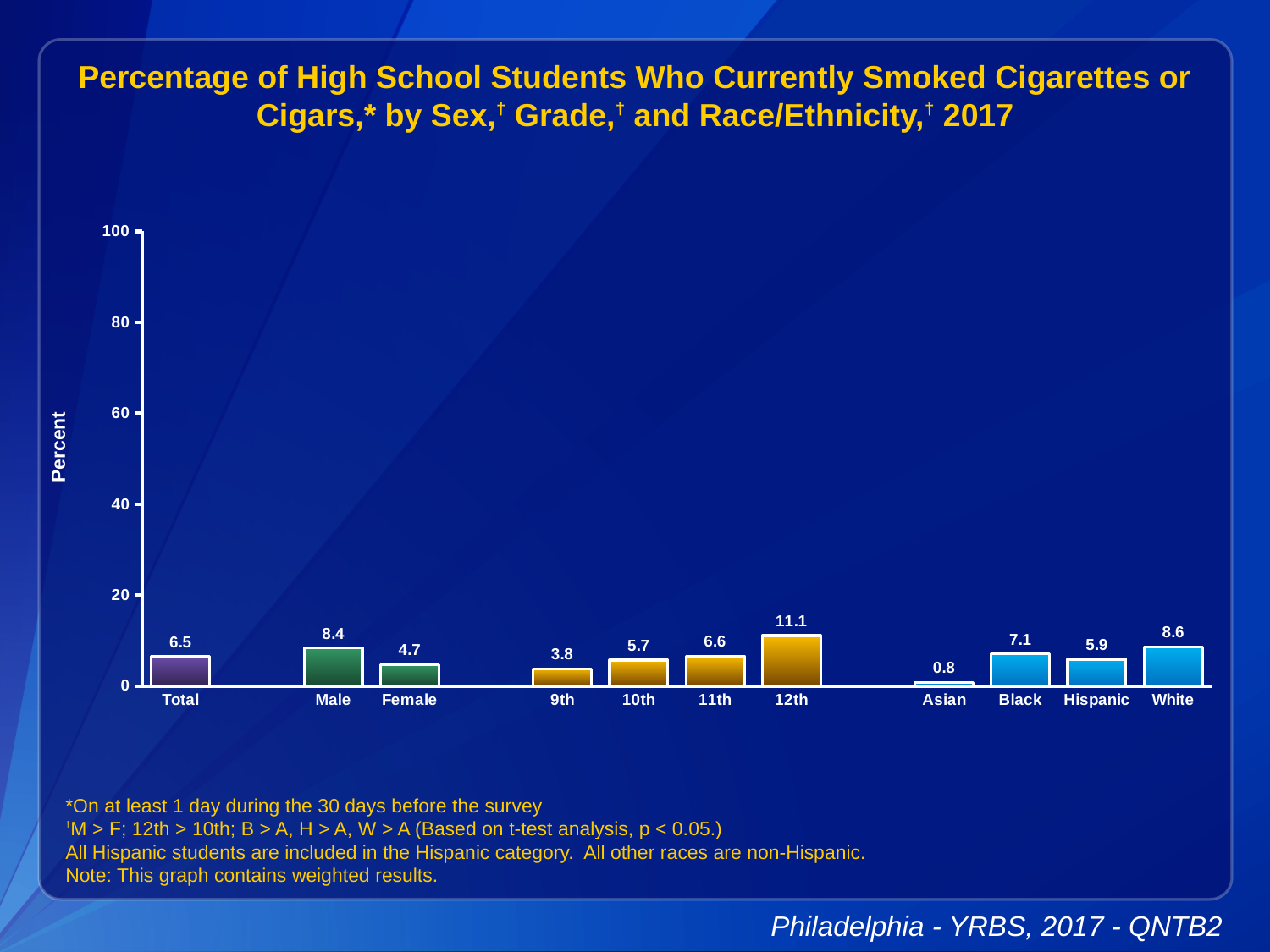
What is the value for 12th grade? 11.1 What is the value for Asian? 0.8 Which is larger, the value for Black or the value for Hispanic? Black Which category has the lowest value? Asian What is the value for Total? 6.5 Do the values rise or fall from 9th grade to 12th grade? rise Which category has the highest value? 12th What kind of chart is this? bar chart Is the value for White greater or less than 20? less What is the value for Male? 8.4 How many categories are shown on the x axis? 11 What is the difference between the Male and Female values? 3.7